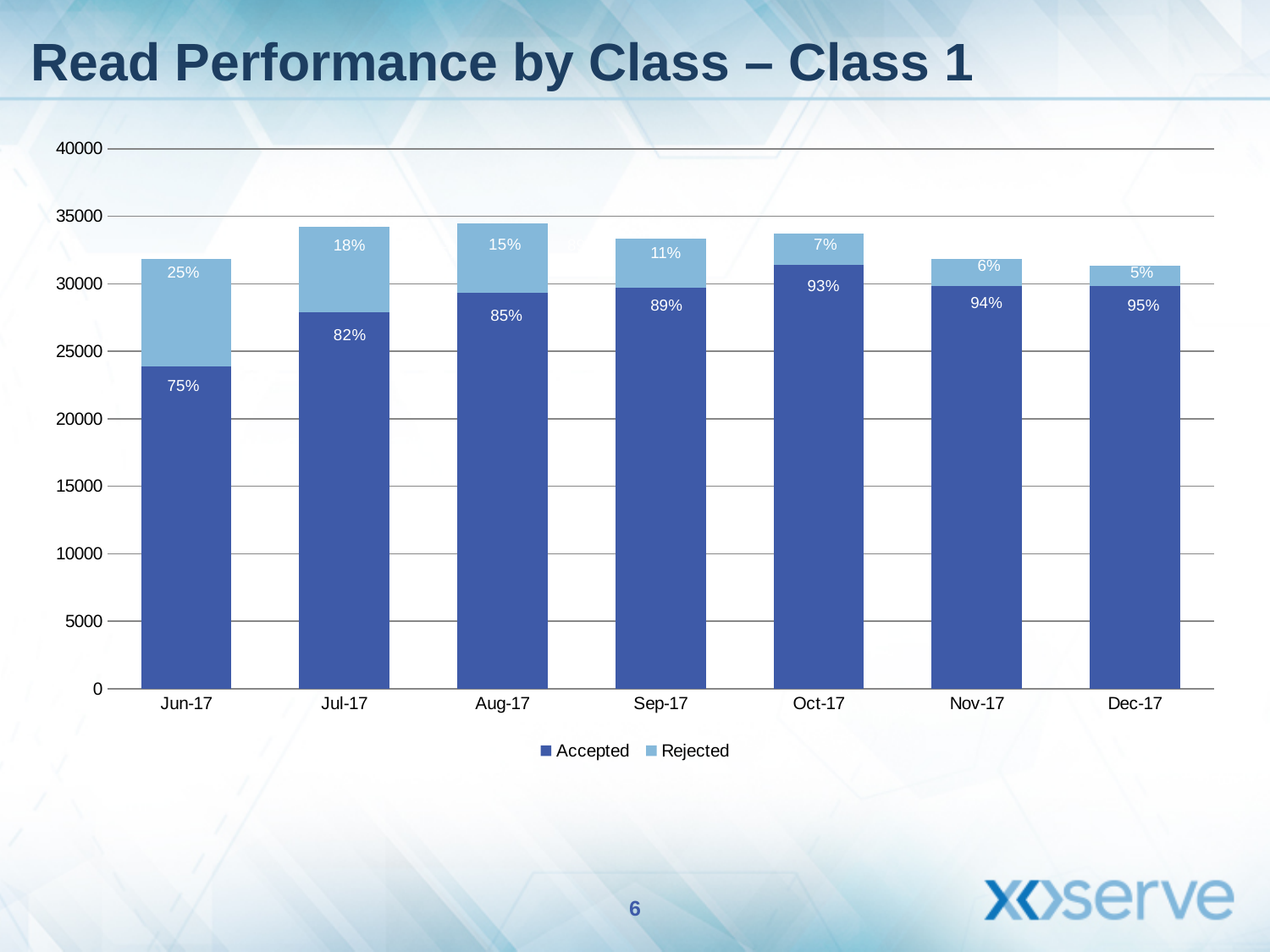
What type of chart is shown on the slide? Stacked bar chart Do the Accepted percentage labels rise or fall from Jun-17 to Dec-17? Rise What is the Rejected percentage label for Aug-17? 15% Which month has the lowest Rejected percentage label? Dec-17 How many series does the legend list? 2 What is the Accepted percentage label for Jun-17? 75% Is the value of the Accepted segment for Jun-17 greater or less than 20000? greater Which month has the highest Accepted percentage label? Dec-17 What is the Accepted percentage label for Oct-17? 93% What is the difference between the Rejected percentage labels for Jun-17 and Jul-17? 7% Which is larger, the Accepted percentage label for Sep-17 or for Nov-17? Nov-17 How many months are shown on the x axis? 7